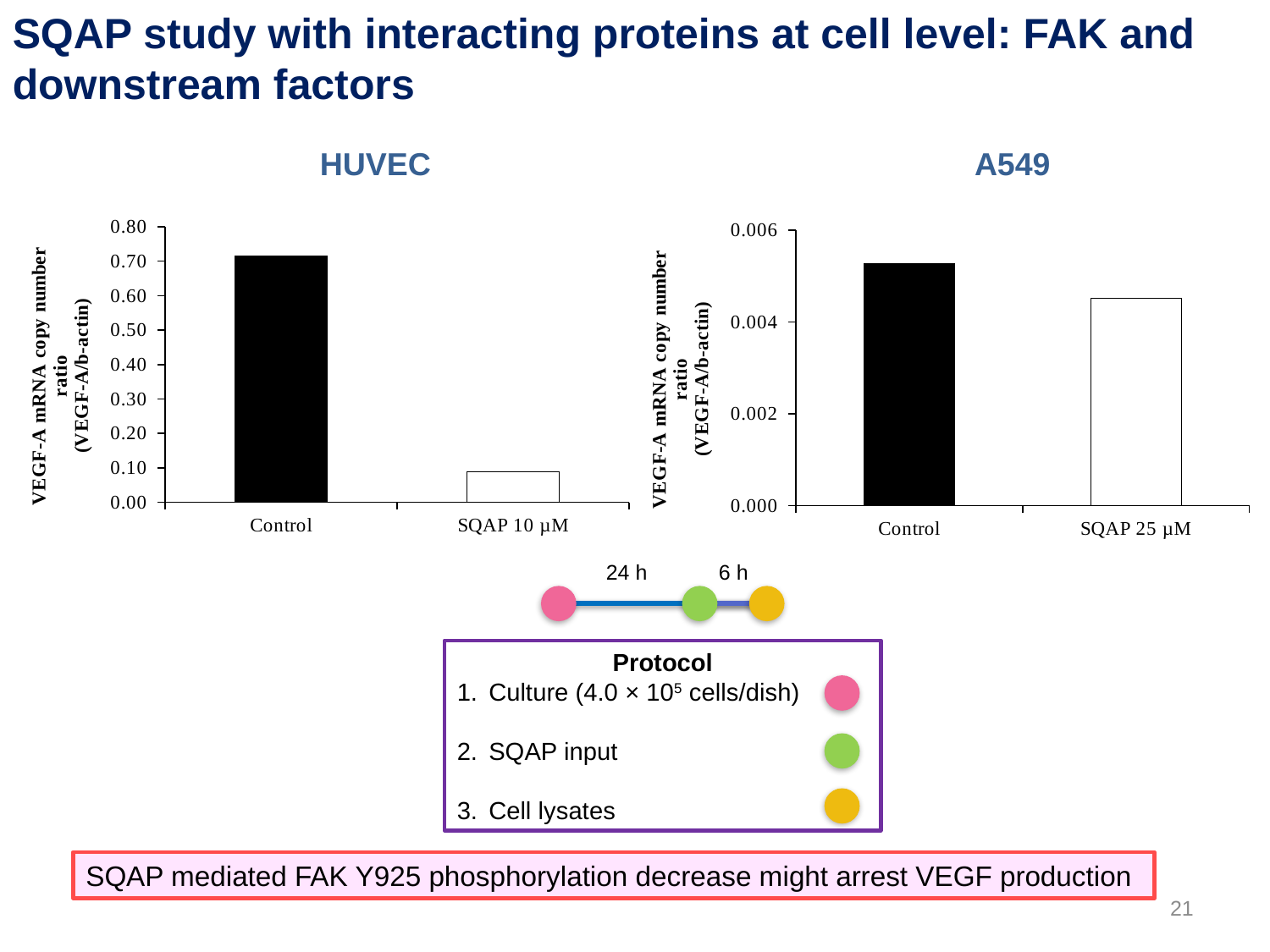
In the HUVEC chart, is the value for SQAP 10 µM greater or less than 0.20? less In the A549 chart, which category has the highest value? Control How many categories are shown on the x axis of the HUVEC chart? 2 In the HUVEC chart, do the values rise or fall from Control to SQAP 10 µM? fall In the A549 chart, is the value for Control greater or less than 0.004? greater In the A549 chart, is the value for SQAP 25 µM greater or less than 0.006? less In the A549 chart, which category has the higher value, Control or SQAP 25 µM? Control In the HUVEC chart, which category has the lowest value? SQAP 10 µM In the A549 chart, what colour is the Control bar? black In the HUVEC chart, which category has the higher value, Control or SQAP 10 µM? Control What kind of chart is the A549 chart? bar chart